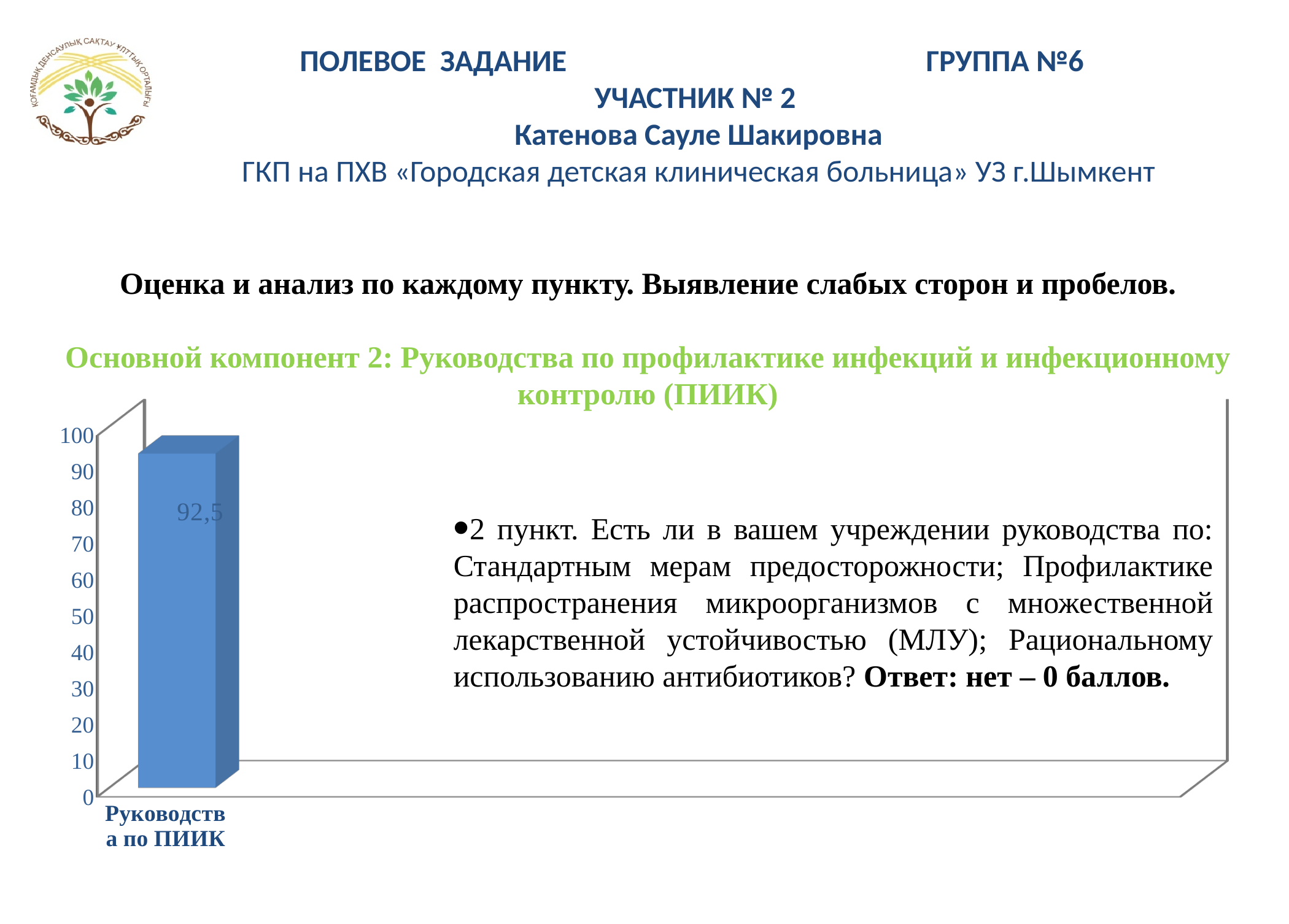
What colour is the bar in the chart? blue How many bars are plotted in the chart? 1 Is the value for "Руководства по ПИИК" greater or less than 90? greater What kind of chart is shown on the slide? bar chart Is the value for "Руководства по ПИИК" greater or less than 100? less What is the label of the category on the x axis of the chart? Руководства по ПИИК What is the highest value shown on the vertical axis of the chart? 100 What is the value shown for the bar labelled "Руководства по ПИИК"? 92,5